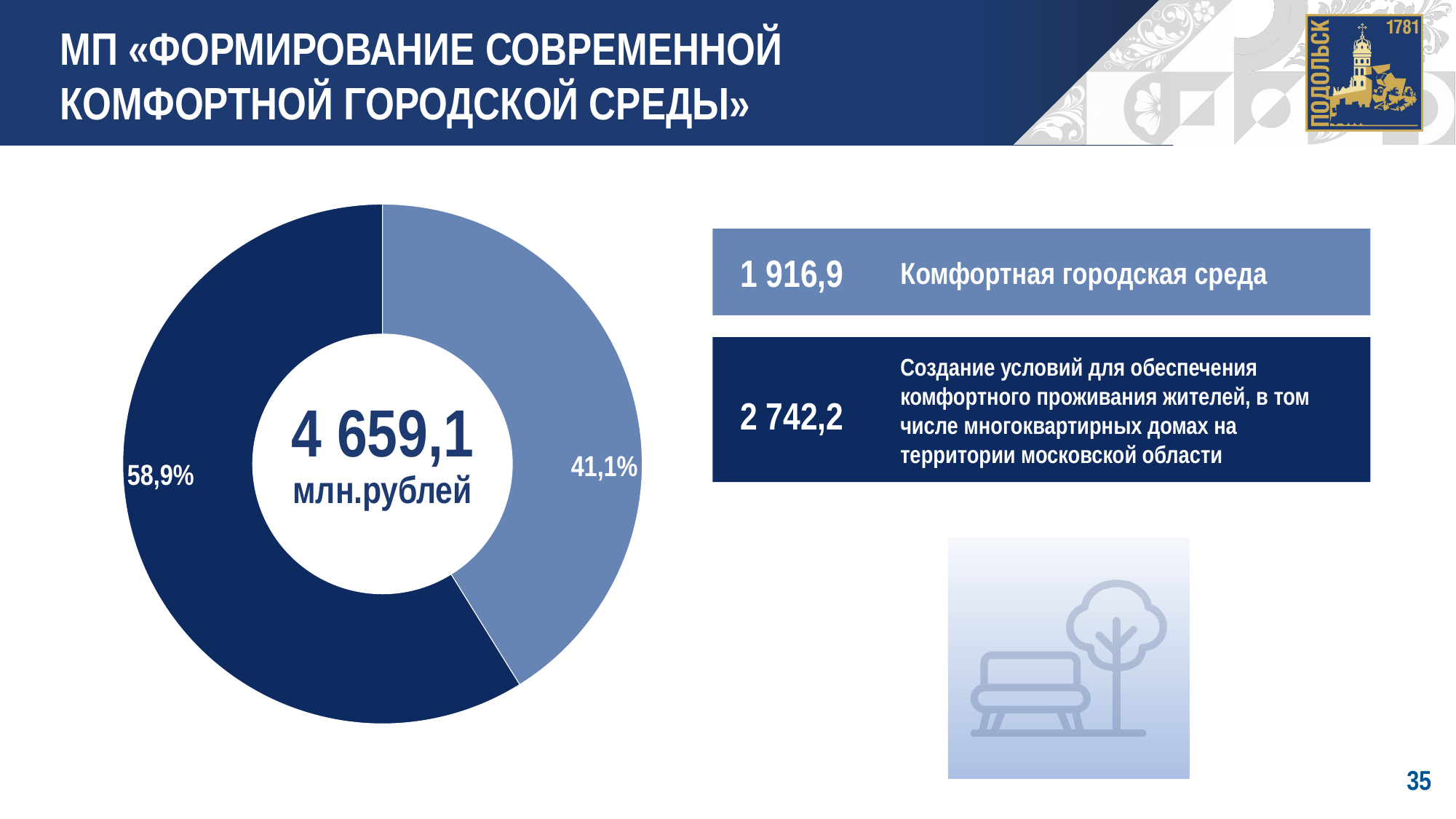
What total value is printed in the centre of the donut chart? 4 659,1 млн.рублей Which category has the largest value? Создание условий для обеспечения комфортного проживания жителей, в том числе многоквартирных домах на территории московской области Which category has the smallest value? Комфортная городская среда How many slices does the donut chart have? 2 Which is larger: the value for «Комфортная городская среда» or the value for «Создание условий для обеспечения комфортного проживания жителей...»? Создание условий для обеспечения комфортного проживания жителей... What kind of chart is shown on the slide? Donut (pie) chart What is the value for «Создание условий для обеспечения комфортного проживания жителей, в том числе многоквартирных домах на территории московской области»? 2 742,2 What is the difference between the value for «Создание условий для обеспечения комфортного проживания жителей...» and the value for «Комфортная городская среда»? 825,3 What colour is the slice representing «Комфортная городская среда»? Light blue What is the value for «Комфортная городская среда»? 1 916,9 What share of the donut chart does the light blue slice represent? 41,1% What share of the donut chart does the dark blue slice represent? 58,9%